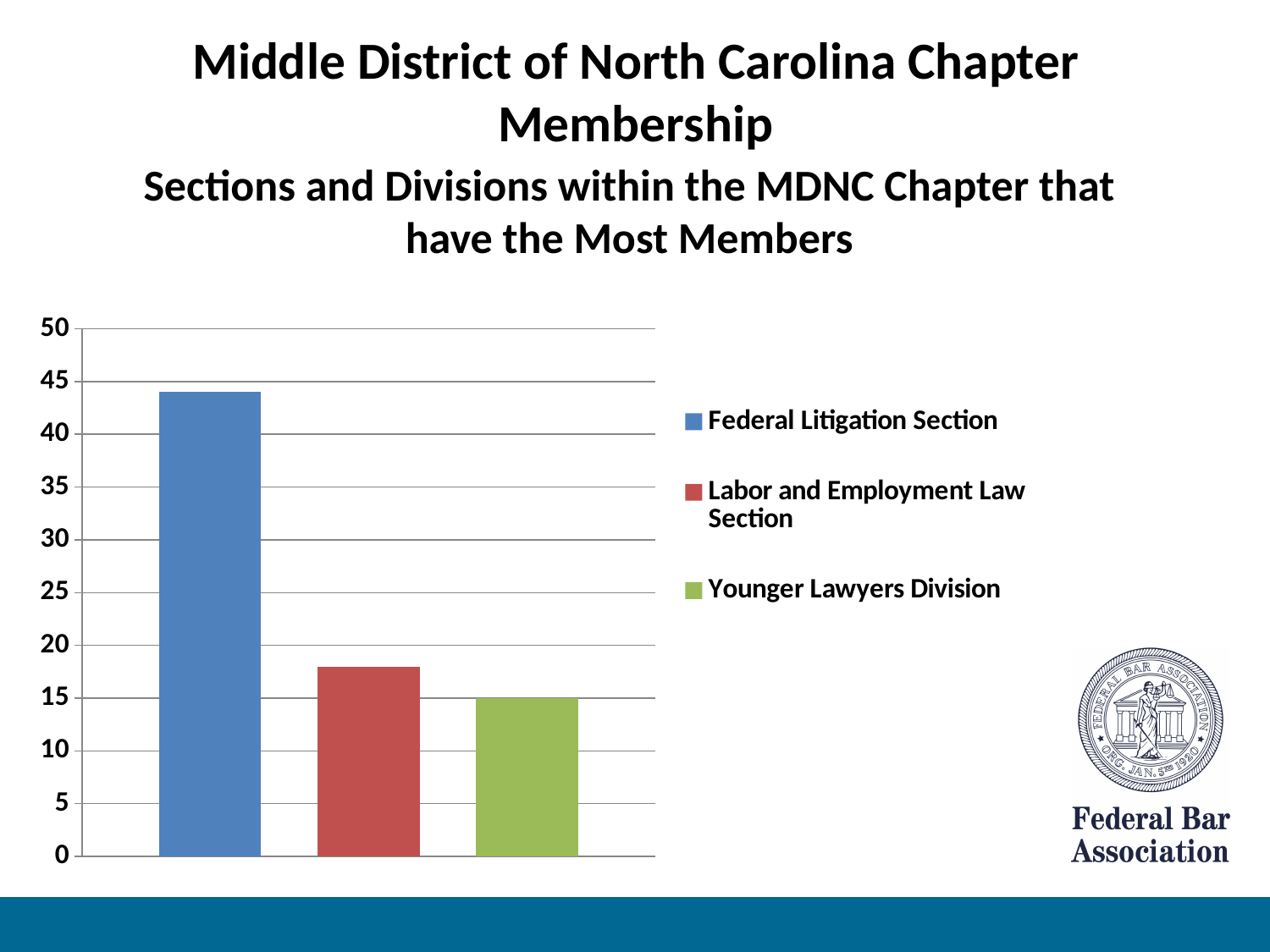
Is the value for Federal Litigation Section greater or less than 40? greater Which has more members, Labor and Employment Law Section or Younger Lawyers Division? Labor and Employment Law Section Which section or division has the highest number of members? Federal Litigation Section What kind of chart is shown on the slide? bar chart Is the value for Younger Lawyers Division greater or less than 20? less Which has more members, Federal Litigation Section or Labor and Employment Law Section? Federal Litigation Section How many bars are plotted in the chart? 3 Which section or division has the lowest number of members? Younger Lawyers Division Is the value for Labor and Employment Law Section greater or less than 20? less How many series does the legend list? 3 What colour is the bar for Younger Lawyers Division? green